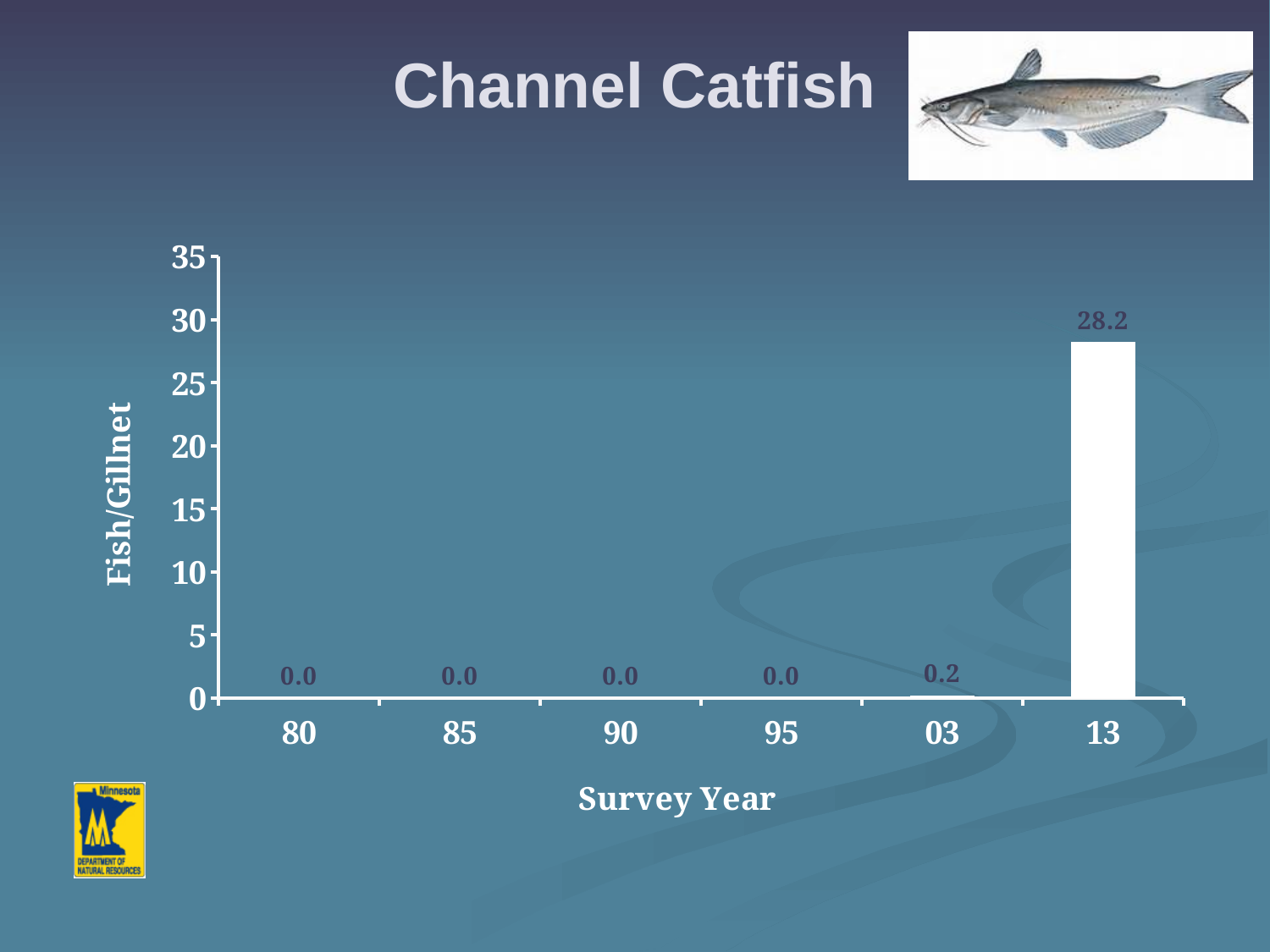
Which survey year has the highest Fish/Gillnet value? 13 What is the Fish/Gillnet value for survey year 80? 0.0 What is the difference in Fish/Gillnet between survey year 13 and survey year 03? 28.0 What is the label of the y axis? Fish/Gillnet What kind of chart is shown on the slide? bar chart Is the Fish/Gillnet value for survey year 13 greater or less than 25? greater What is the title of the slide? Channel Catfish Which has a larger Fish/Gillnet value, survey year 03 or survey year 13? 13 How many survey years are shown on the x axis? 6 How many survey years have a Fish/Gillnet value of 0.0? 4 What is the Fish/Gillnet value for survey year 03? 0.2 What is the Fish/Gillnet value for survey year 13? 28.2